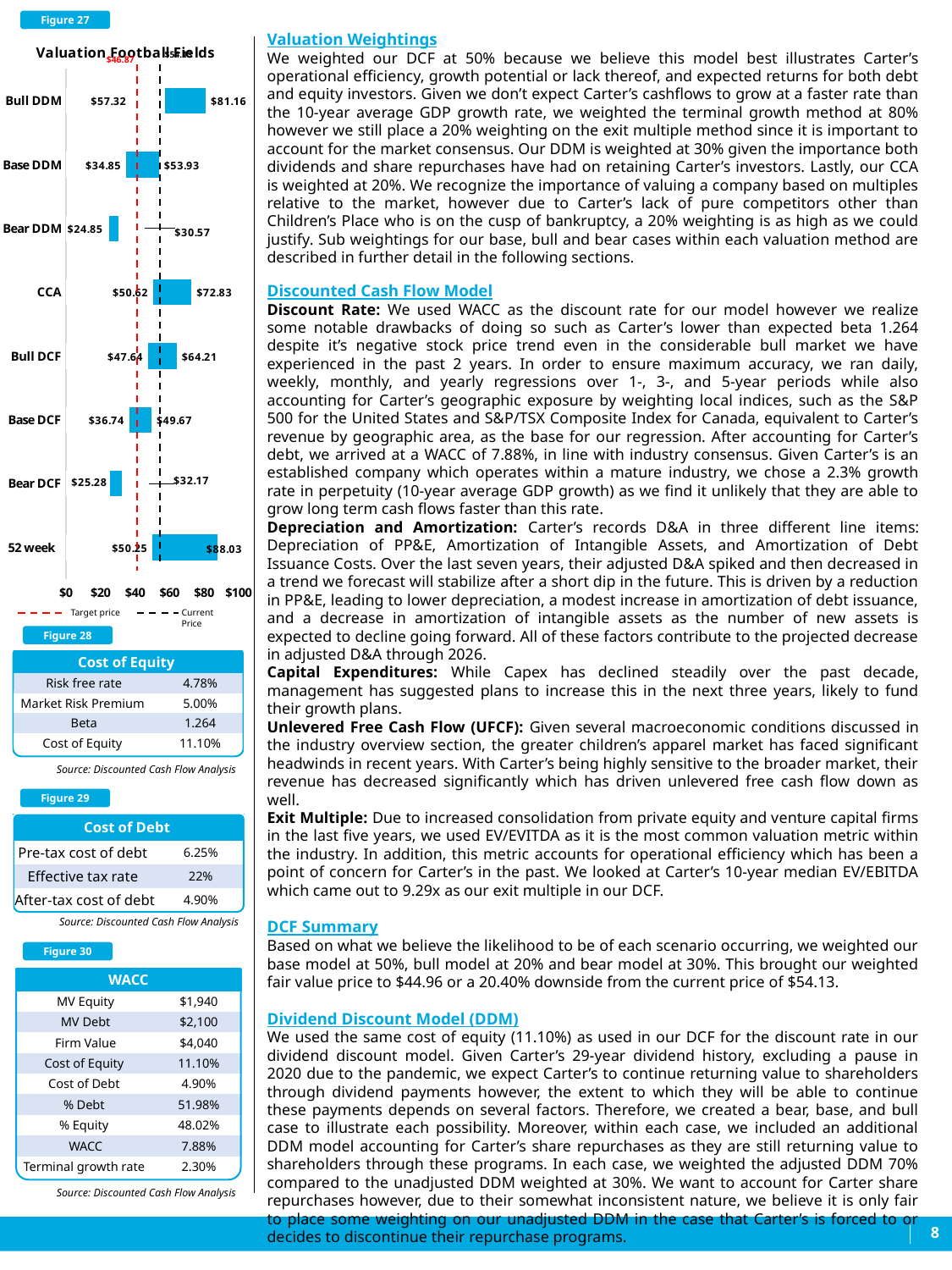
In the Valuation Football Fields chart, what is the high value shown for Bull DDM? $81.16 In the Valuation Football Fields chart, what is the difference between the high and low values for Bull DDM? $23.84 In the Valuation Football Fields chart, what is the high value shown for CCA? $72.83 In the Valuation Football Fields chart, which is larger: the high value for Bull DDM or the high value for CCA? Bull DDM How many categories are shown in the Valuation Football Fields chart? 8 In the Valuation Football Fields chart, what is the high value shown for 52 week? $88.03 In the Valuation Football Fields chart, which category has the lowest low value? Bear DDM In the Valuation Football Fields chart, what is the low value shown for Base DCF? $36.74 What kind of chart is the Valuation Football Fields chart? Bar chart In the Valuation Football Fields chart, what is the difference between the high and low values for Bear DCF? $6.89 In the Valuation Football Fields chart, which category has the highest upper value? 52 week In the Valuation Football Fields chart, what is the low value shown for Bear DDM? $24.85